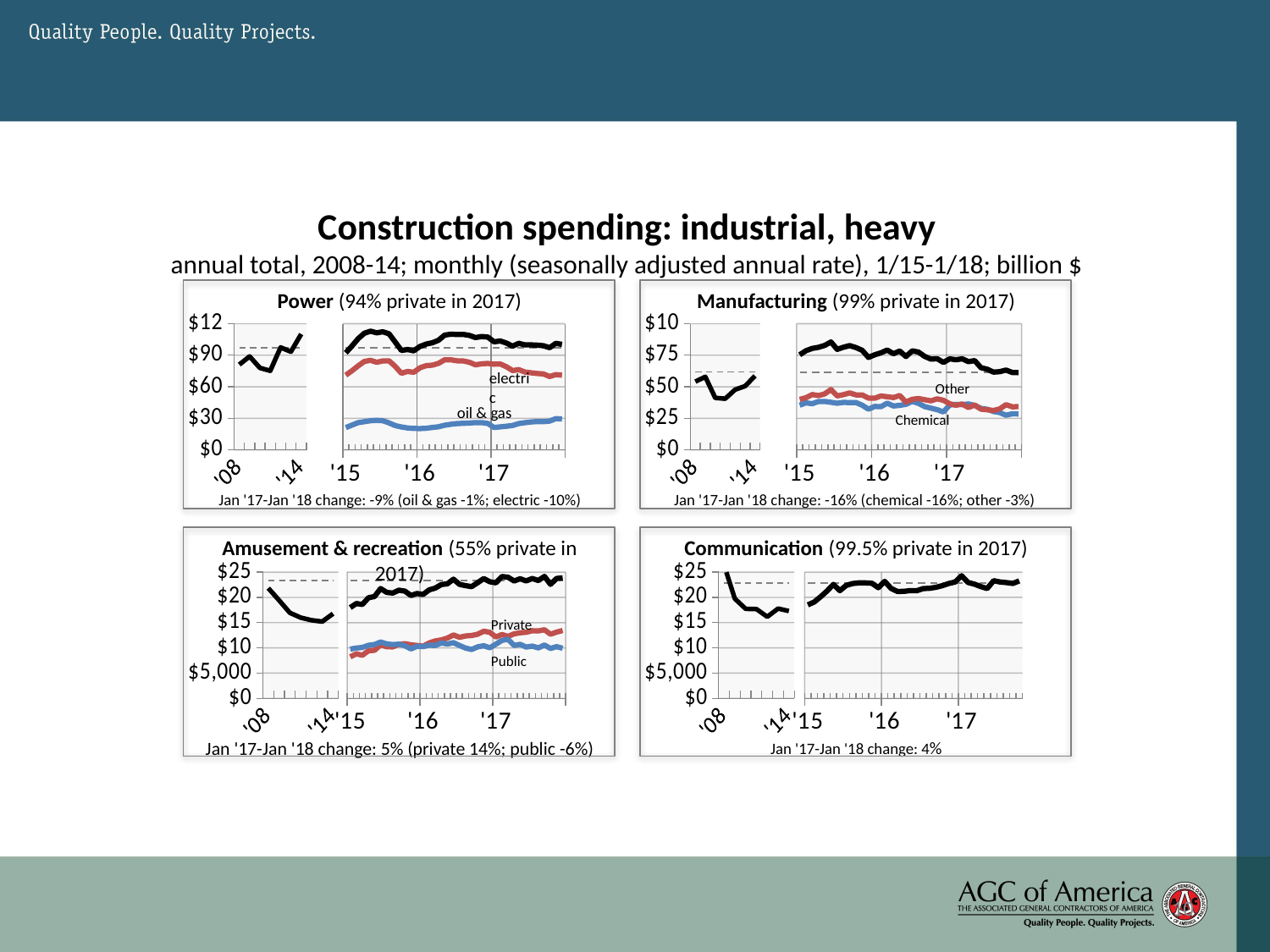
According to the Power chart title, what share of power construction spending was private in 2017? 94% In the Amusement & recreation chart, which series is higher at the end of 2017, Private or Public? Private In the Manufacturing chart, is the Chemical value in 2017 greater or less than $50? less In the Power chart, which series is higher in 2017, electric or oil & gas? electric In the Manufacturing chart, does the total (black line) rise or fall from 2015 to 2018? fall In the Communication chart, is the value in 2017 greater or less than $20? greater What kind of chart is used in the Power panel? line chart In the Communication chart, what is the Jan '17-Jan '18 change? 4% In the Manufacturing chart, what is the Jan '17-Jan '18 change for chemical? -16%